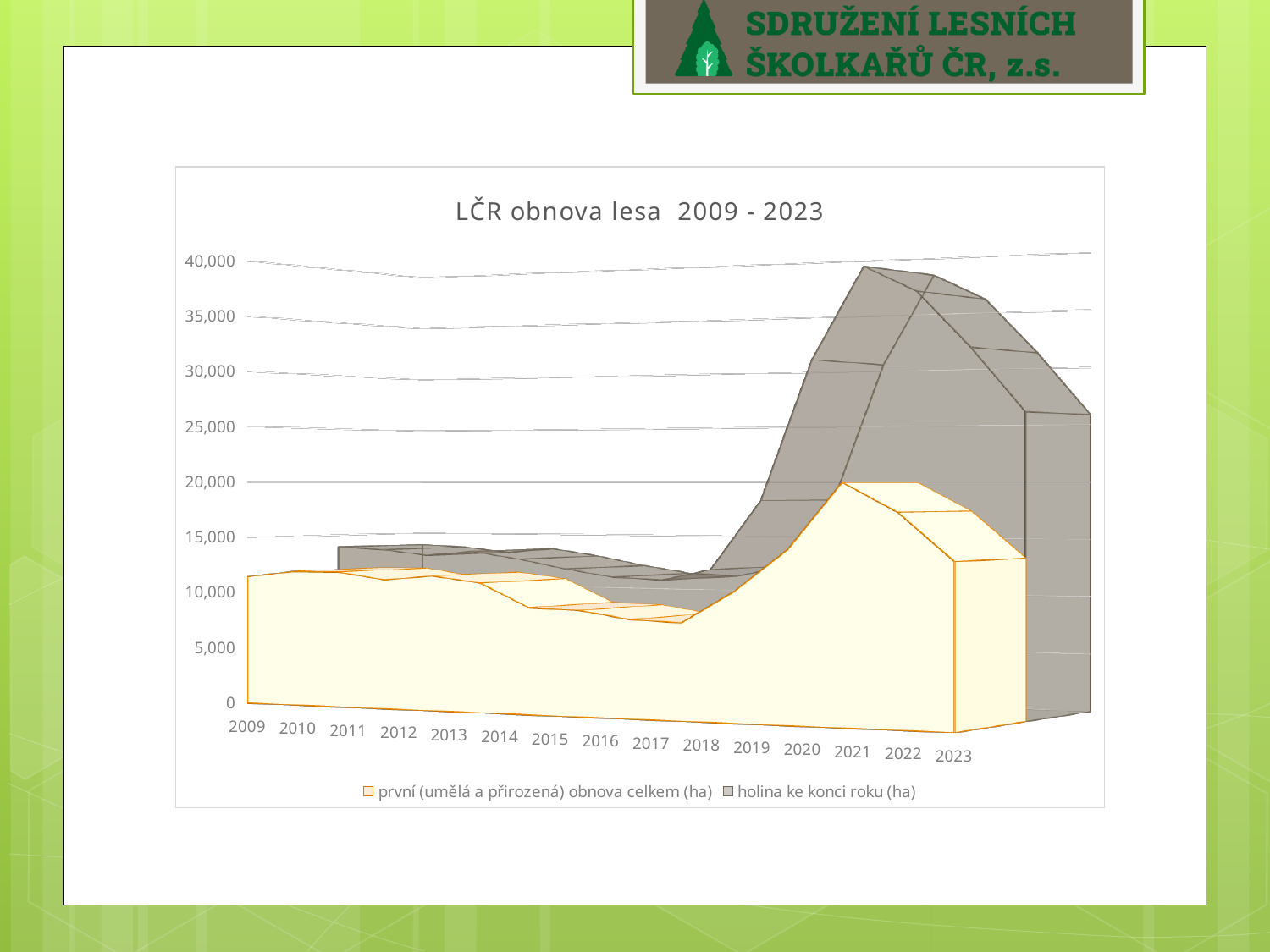
Does the value for 'první (umělá a přirozená) obnova celkem (ha)' rise or fall from 2017 to 2021? rise Is the value for 'holina ke konci roku (ha)' in 2020 greater or less than 35,000? greater What kind of chart is shown on the slide? Area chart Is the value for 'holina ke konci roku (ha)' larger in 2020 or in 2009? 2020 In which year is the value for 'holina ke konci roku (ha)' highest? 2020 Which is larger in 2020: 'holina ke konci roku (ha)' or 'první (umělá a přirozená) obnova celkem (ha)'? holina ke konci roku (ha) How many years are shown on the x axis? 15 What is the title of the chart? LČR obnova lesa 2009 - 2023 Does the value for 'holina ke konci roku (ha)' rise or fall from 2020 to 2023? fall What are the two series named in the legend? první (umělá a přirozená) obnova celkem (ha) and holina ke konci roku (ha) How many series does the legend list? 2 Is the value for 'první (umělá a přirozená) obnova celkem (ha)' in 2017 greater or less than 10,000? less